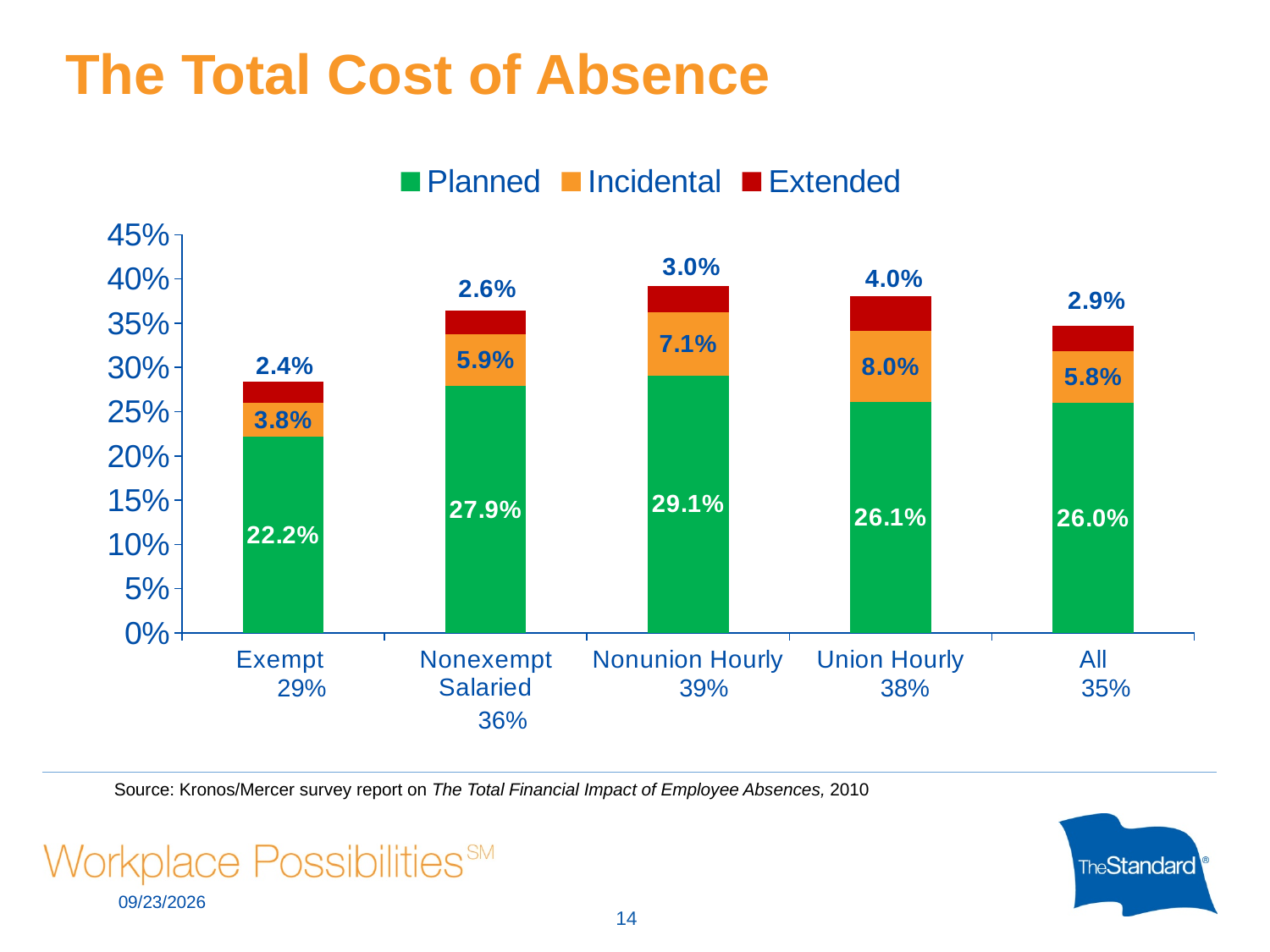
What is the difference between the Incidental values for Union Hourly and Exempt? 4.2% Which category has the lowest Planned value? Exempt What is the Incidental value for Union Hourly? 8.0% Which category has the highest Planned value? Nonunion Hourly What is the Extended value for Exempt? 2.4% How many employee categories are shown on the x axis? 5 How many series does the legend list? 3 Is the total height of the Exempt bar greater or less than 30%? less What is the Planned value for Nonunion Hourly? 29.1% What total percentage is printed under the Nonunion Hourly category label? 39% Which is larger, the Extended value for Union Hourly or for Nonexempt Salaried? Union Hourly What type of chart is shown on the slide? stacked bar chart